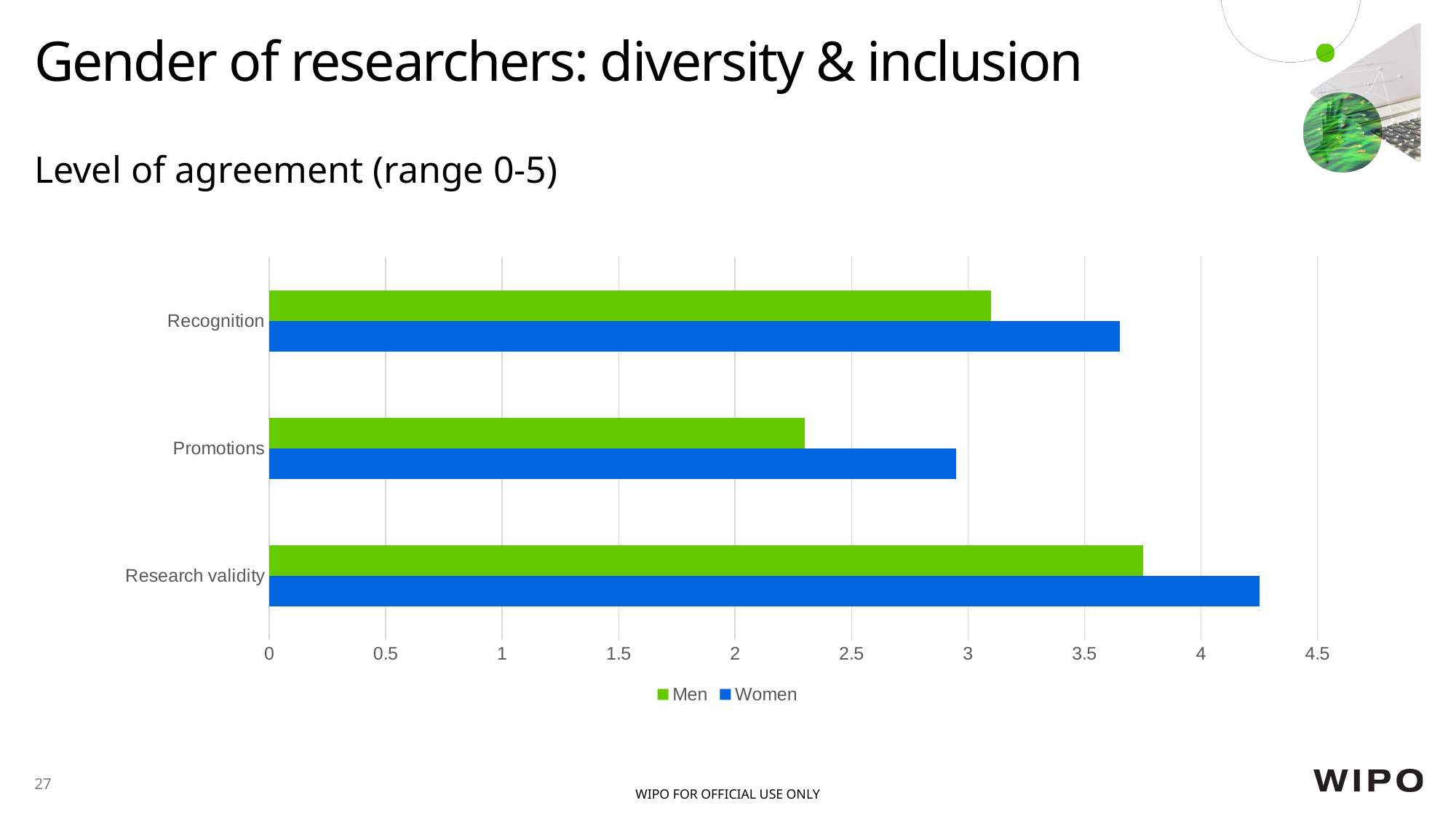
What kind of chart is shown on the slide? bar chart Is the value for Men in Research validity greater or less than 3.5? greater Which category has the lowest value for Men? Promotions For Recognition, which is larger, the value for Men or for Women? Women How many series does the legend list? 2 Is the value for Men in Promotions greater or less than 2.5? less Which category has the highest value for Women? Research validity How many categories are shown on the chart? 3 Is the value for Women in Research validity greater or less than 4? greater Which colour represents the Men series in the legend? green For Promotions, which is larger, the value for Men or for Women? Women